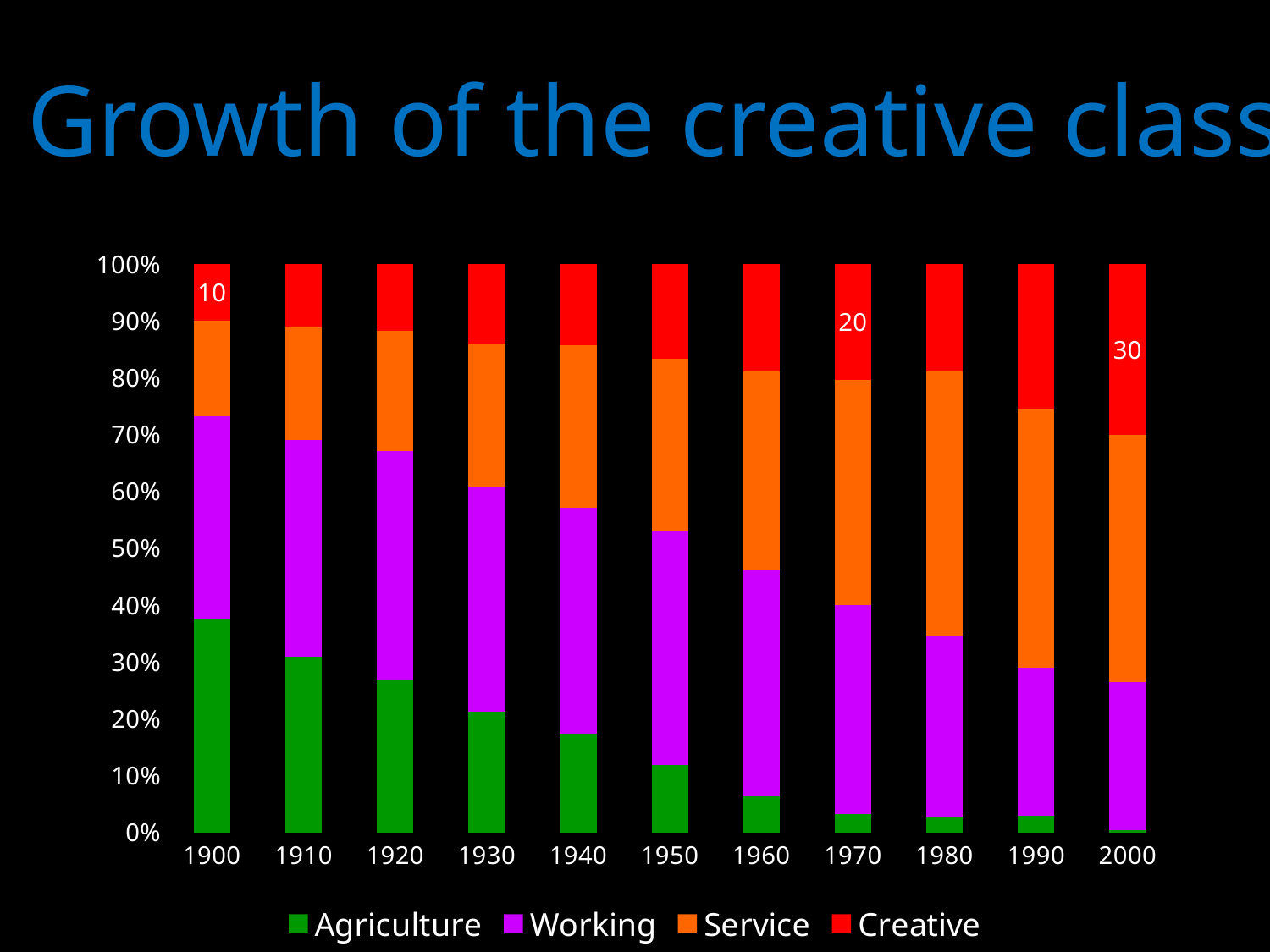
What is the data label shown for the Creative segment in 2000? 30 How many series does the legend list? 4 In which year is the Agriculture share the largest? 1900 What is the title of the slide? Growth of the creative class Does the Agriculture share rise or fall from 1900 to 2000? Fall By how much does the labelled Creative value in 2000 exceed the labelled Creative value in 1900? 20 What kind of chart is shown on the slide? Stacked bar chart Is the Agriculture share in 1960 greater or less than 10%? less How many years are shown along the x axis? 11 What is the data label shown for the Creative segment in 1970? 20 What is the data label shown for the Creative segment in 1900? 10 Is the Agriculture share in 1900 greater or less than 30%? greater